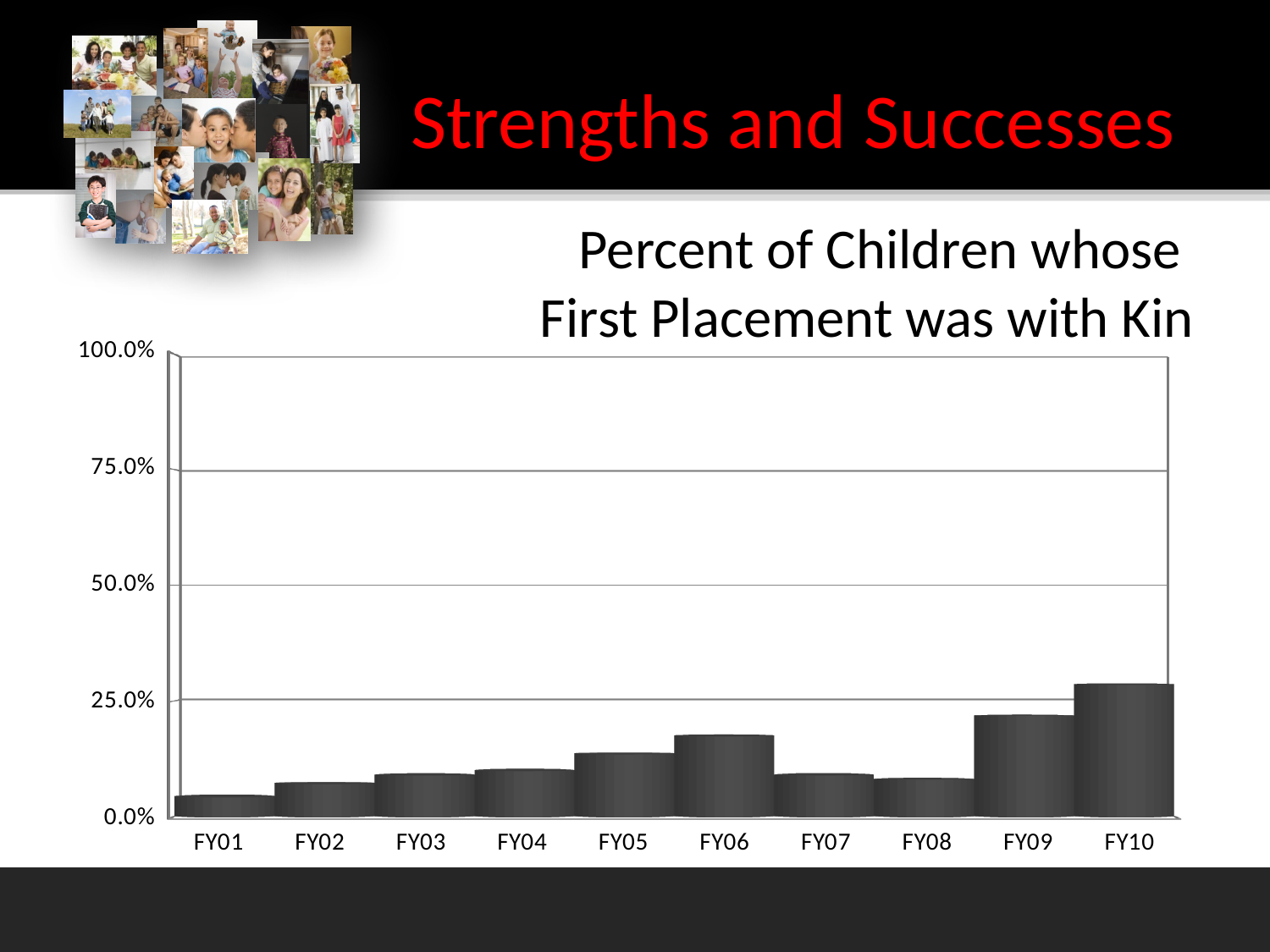
What is the title of the chart? Percent of Children whose First Placement was with Kin Overall, do the values rise or fall from FY01 to FY10? rise Which fiscal year has the highest percent of children whose first placement was with kin? FY10 What kind of chart is shown on the slide? bar chart Is the value for FY10 greater or less than 50.0%? less Which fiscal year has the lowest percent of children whose first placement was with kin? FY01 Is the value for FY10 greater or less than 25.0%? greater Which is larger, the value for FY09 or the value for FY08? FY09 Is the value for FY09 greater or less than 25.0%? less How many fiscal years are shown on the x axis of the chart? 10 Which is larger, the value for FY06 or the value for FY05? FY06